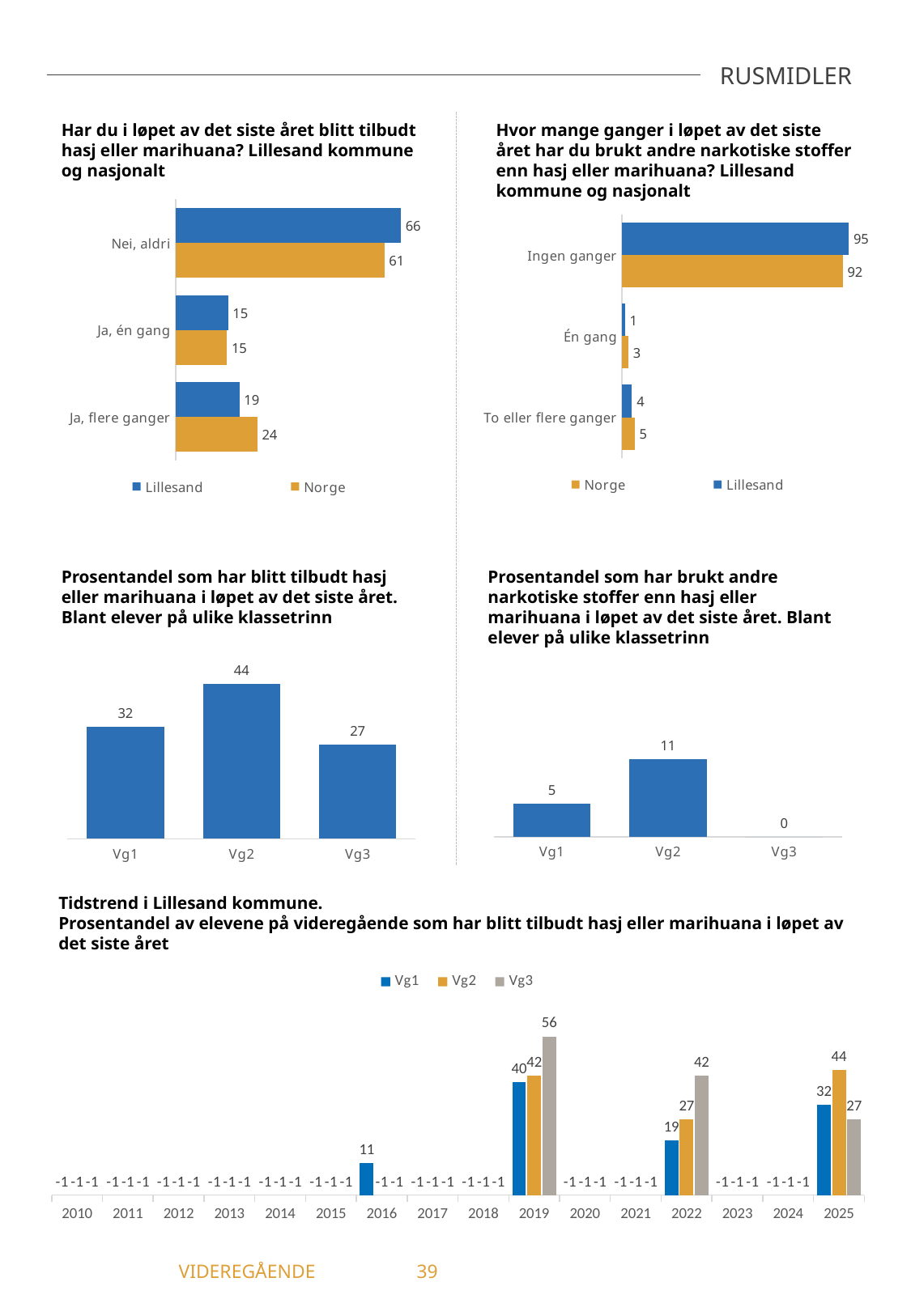
In the middle-right chart 'Prosentandel som har brukt andre narkotiske stoffer', what is the difference between Vg2 and Vg1? 6 What kind of chart is the bottom chart 'Tidstrend i Lillesand kommune'? Bar chart In the top-left chart 'Har du i løpet av det siste året blitt tilbudt hasj eller marihuana?', what is the difference between Norge and Lillesand for 'Ja, flere ganger'? 5 In the top-left chart 'Har du i løpet av det siste året blitt tilbudt hasj eller marihuana?', what is the value for Lillesand for 'Nei, aldri'? 66 In the bottom chart 'Tidstrend i Lillesand kommune', what is the value for Vg1 in 2016? 11 In the bottom chart 'Tidstrend i Lillesand kommune', what is the value for Vg3 in 2019? 56 In the middle-left chart 'Prosentandel som har blitt tilbudt hasj eller marihuana', which class level has the highest value? Vg2 In the middle-right chart 'Prosentandel som har brukt andre narkotiske stoffer', which class level has the lowest value? Vg3 In the top-right chart about other narcotic substances, which is larger for 'Én gang': Lillesand or Norge? Norge How many series does the legend list in the top-right chart about other narcotic substances? 2 In the middle-left chart 'Prosentandel som har blitt tilbudt hasj eller marihuana', what is the value for Vg3? 27 In the top-right chart about other narcotic substances, what is the value for Norge for 'Ingen ganger'? 92